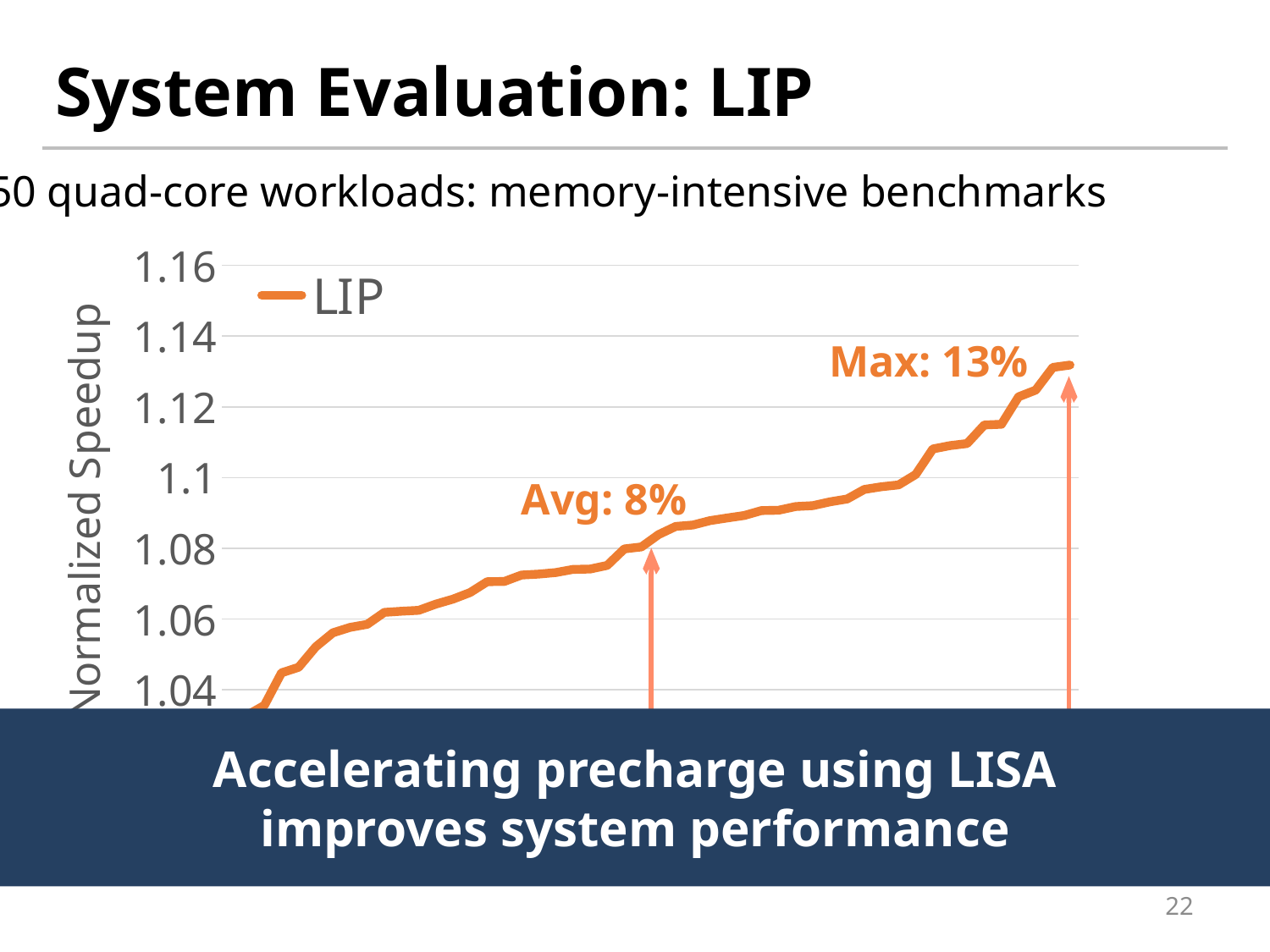
What is the highest tick value shown on the y axis? 1.16 What average speedup is annotated on the chart? Avg: 8% Is the highest value of the LIP line greater or less than 1.12? greater How many series does the legend list? 1 Do the LIP values rise or fall from left to right along the x axis? rise Which is larger, the annotated average speedup or the annotated maximum speedup? the maximum (13%) Is the leftmost visible value of the LIP line greater or less than 1.06? less Is the highest value of the LIP line greater or less than 1.14? less What is the name of the series shown in the legend? LIP What kind of chart is shown on the slide? line chart What maximum speedup is annotated on the chart? Max: 13% What is the label on the y axis? Normalized Speedup